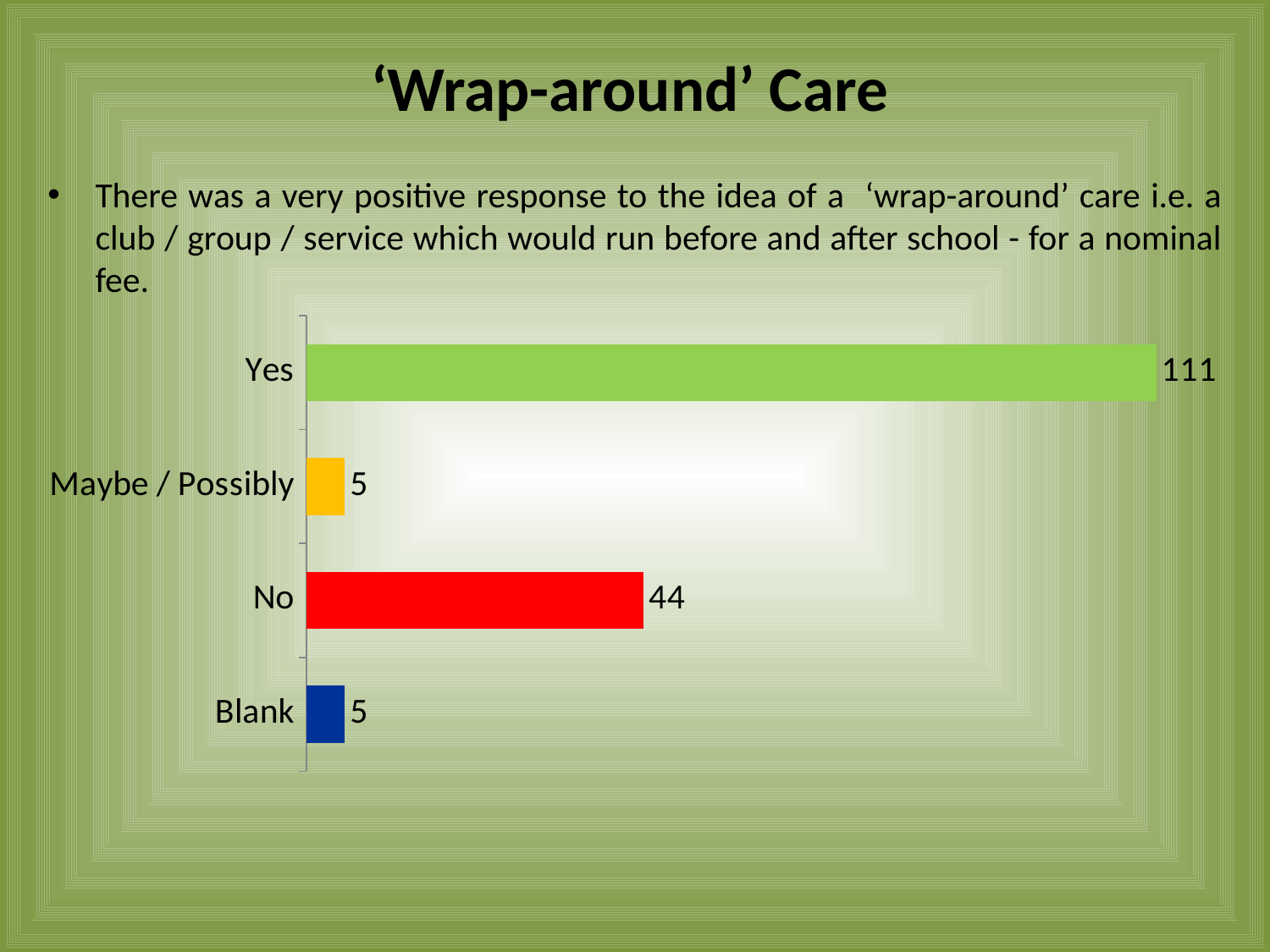
What is the value for Yes? 111 How many categories are shown in the chart? 4 What is the value for Maybe / Possibly? 5 What is the difference between the values for Yes and No? 67 What is the value for No? 44 Which is larger, the value for No or the value for Maybe / Possibly? No What is the value for Blank? 5 What is the difference between the values for No and Blank? 39 What kind of chart is shown on the slide? Bar chart What colour is the bar for No? Red How many categories have a value of 5? 2 Which category has the highest value? Yes